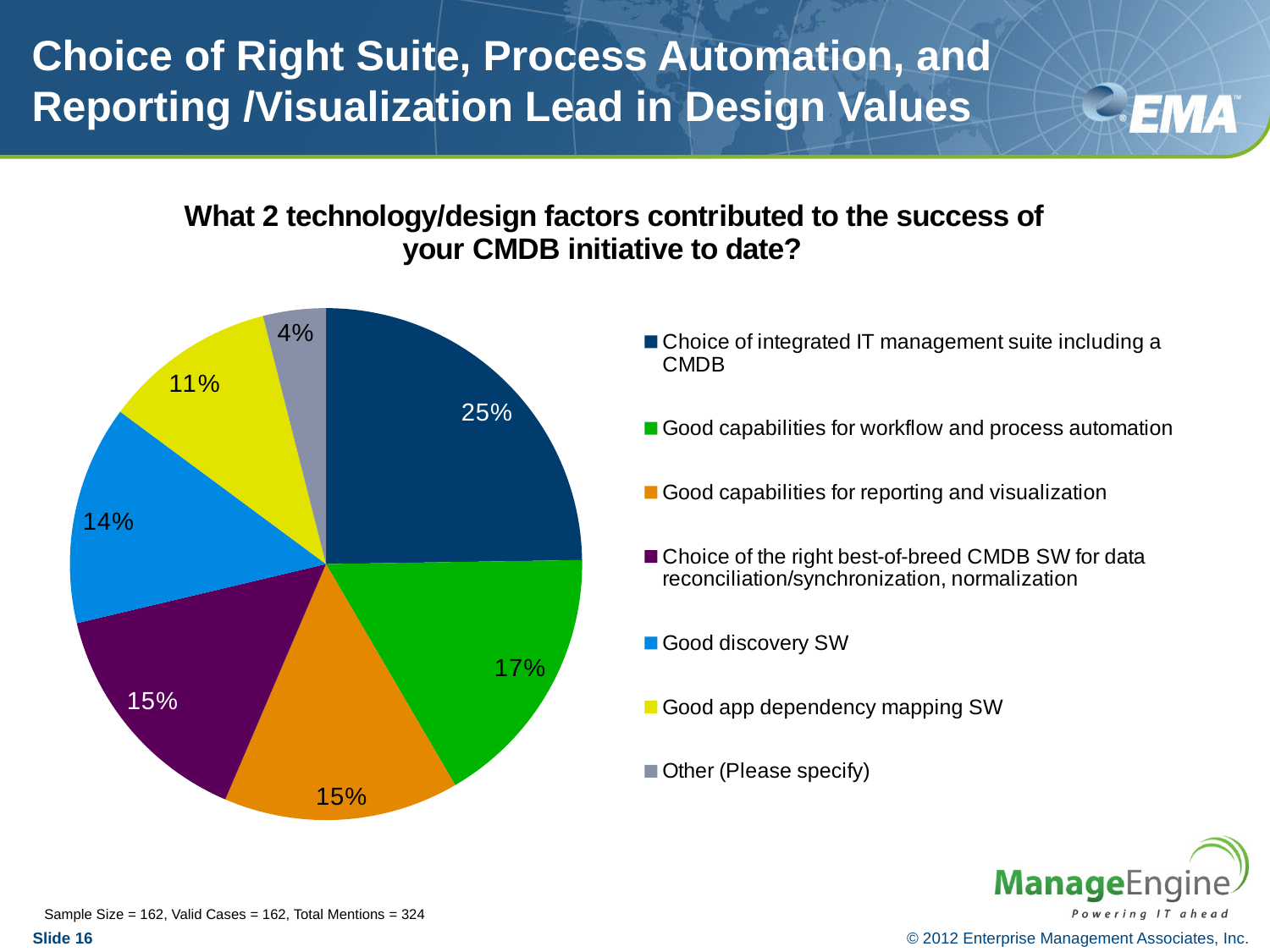
Which category has the largest slice of the pie? Choice of integrated IT management suite including a CMDB What kind of chart is shown on the slide? pie chart Which is larger: the share for "Good capabilities for workflow and process automation" or the share for "Good app dependency mapping SW"? Good capabilities for workflow and process automation What share of the pie does "Good capabilities for workflow and process automation" have? 17% How many categories does the legend list? 7 What colour is the slice for "Good capabilities for reporting and visualization"? orange What share of the pie does "Good app dependency mapping SW" have? 11% What is the difference in percentage points between "Choice of integrated IT management suite including a CMDB" and "Good discovery SW"? 11 What share of the pie does "Other (Please specify)" have? 4% What share of the pie does "Choice of integrated IT management suite including a CMDB" have? 25% Which category has the smallest slice of the pie? Other (Please specify) What share of the pie does "Good discovery SW" have? 14%